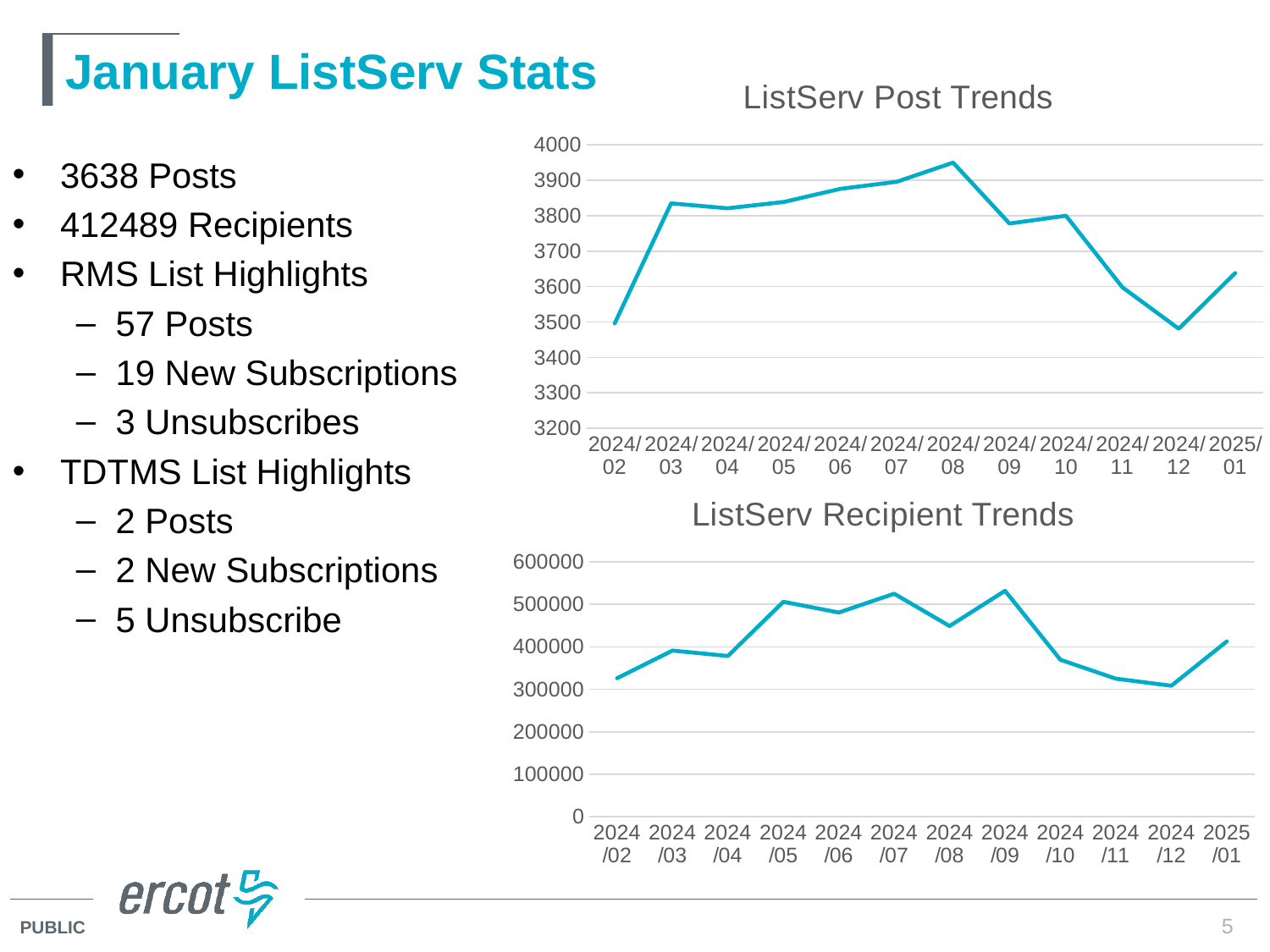
On the "ListServ Post Trends" chart, is the value for 2024/03 greater or less than 3800? greater What is the title of the lower chart on the slide? ListServ Recipient Trends On the "ListServ Recipient Trends" chart, which is larger, the value for 2024/09 or the value for 2024/12? 2024/09 On the "ListServ Post Trends" chart, is the value for 2024/08 greater or less than 3900? greater How many data points are plotted on the "ListServ Recipient Trends" chart? 12 What kind of chart is the "ListServ Post Trends" chart? line chart On the "ListServ Recipient Trends" chart, is the value for 2024/12 greater or less than 400000? less On the "ListServ Post Trends" chart, which is larger, the value for 2024/08 or the value for 2024/12? 2024/08 On the "ListServ Post Trends" chart, which month has the highest value? 2024/08 On the "ListServ Post Trends" chart, do the values rise or fall from 2024/08 to 2024/12? fall